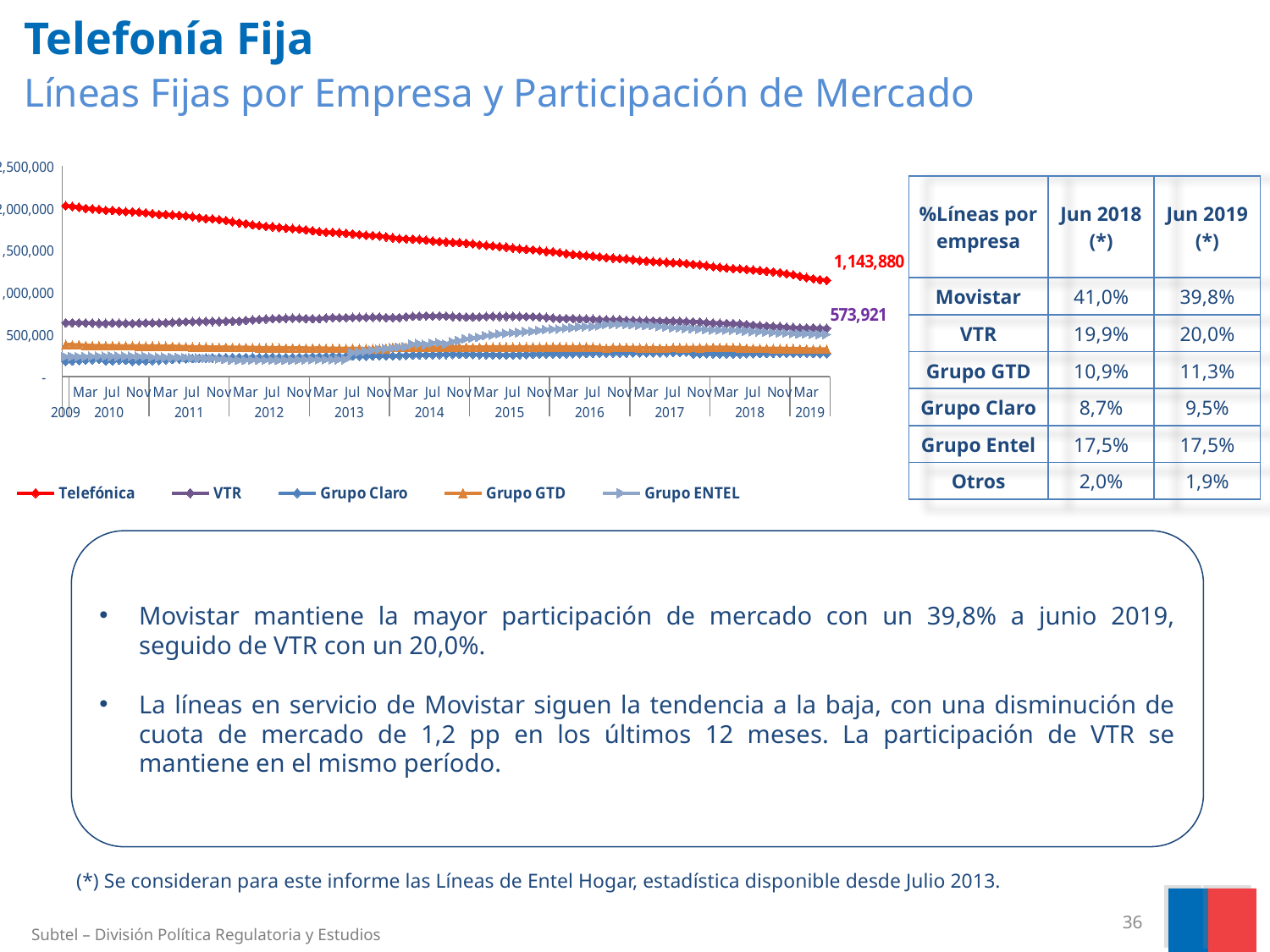
What kind of chart is shown on the slide? line chart Which series has the highest values throughout the chart? Telefónica Does the Grupo ENTEL line rise or fall between 2013 and 2019? rise What is the labelled final value for Telefónica on the chart? 1,143,880 What is the labelled final value for VTR on the chart? 573,921 What is the difference between the labelled final values of Telefónica (1,143,880) and VTR (573,921)? 569,959 How many series does the chart legend list? 5 What colour is the Telefónica series in the chart legend? red Is the final value for Telefónica greater or less than 1,500,000? less Is the value for Grupo GTD in 2019 greater or less than 500,000? less Does the Telefónica line rise or fall from 2009 to 2019? fall Which is larger at the end of the chart, the value for Telefónica or the value for VTR? Telefónica